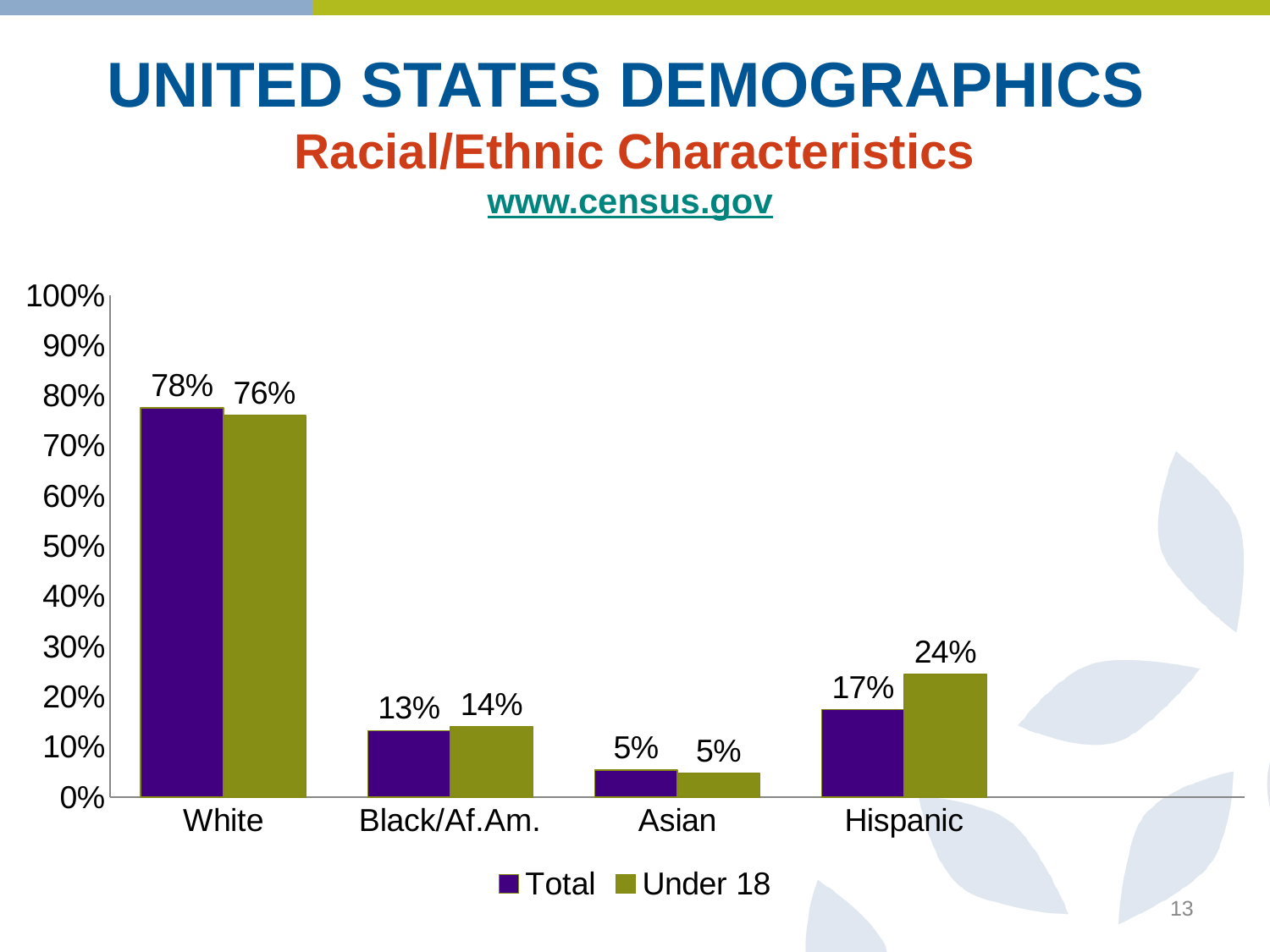
Which is larger for Hispanic, the Total value or the Under 18 value? Under 18 What kind of chart is shown on the slide? Bar chart Which category has the lowest Under 18 value? Asian Which category has the highest Total value? White What is the Under 18 value for Hispanic? 24% What is the difference between the Under 18 and Total values for Hispanic? 7% How many series does the legend list? 2 How many categories are shown on the x axis? 4 What is the Under 18 value for Black/Af.Am.? 14% What is the Total value for White? 78% What is the difference between the Total and Under 18 values for White? 2% What are the two series named in the legend? Total and Under 18